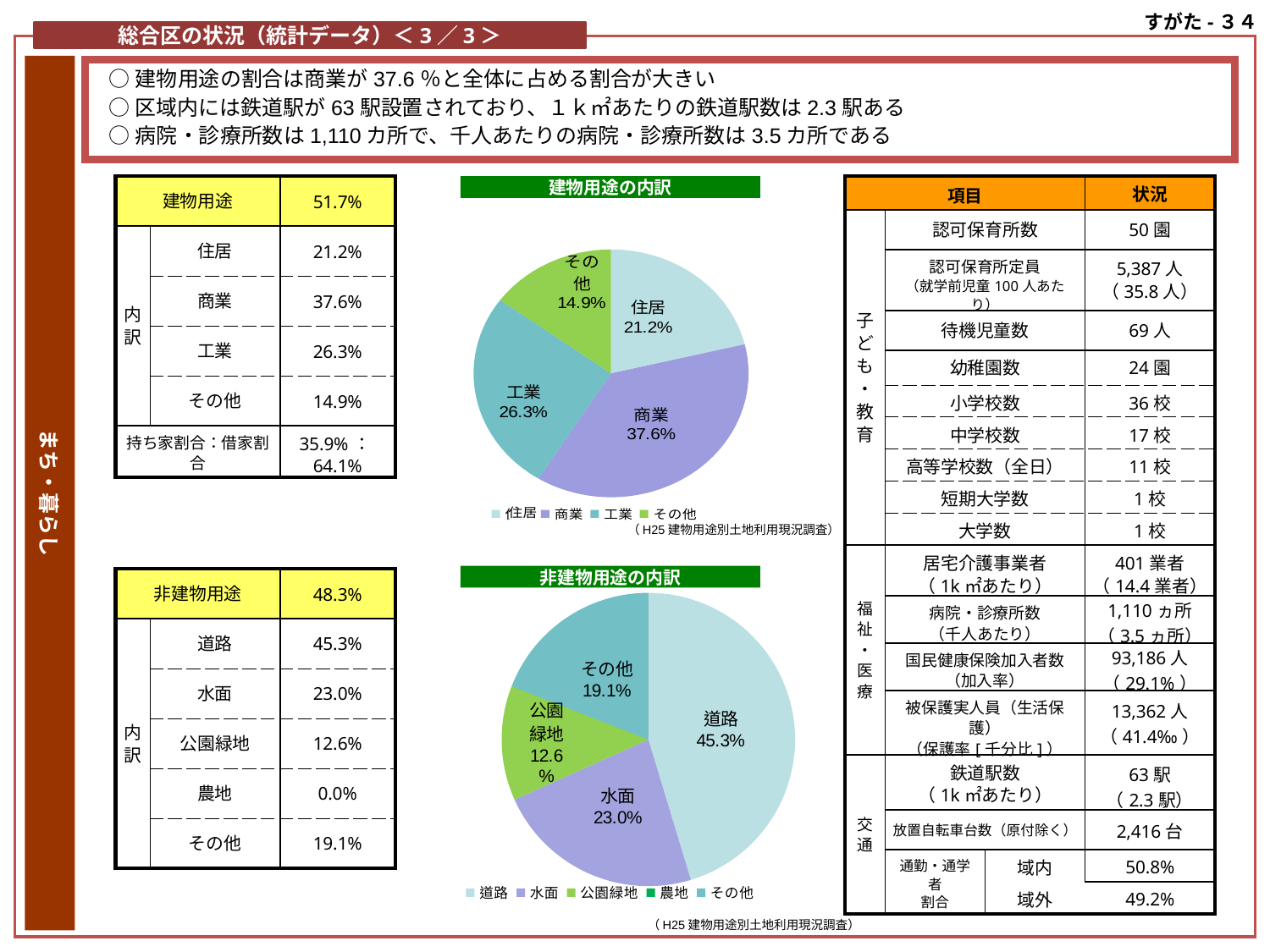
In the 非建物用途の内訳 pie chart, what is the difference between the shares of 道路 and 水面? 22.3% In the 建物用途の内訳 pie chart, what share does 商業 have? 37.6% In the 非建物用途の内訳 pie chart, which is larger, その他 or 公園緑地? その他 In the 建物用途の内訳 pie chart, which category has the largest share? 商業 In the 建物用途の内訳 pie chart, which category has the smallest share? その他 In the 非建物用途の内訳 pie chart, how many categories does the legend list? 5 In the 非建物用途の内訳 pie chart, what is the share of 公園緑地? 12.6% What type of chart is 建物用途の内訳? Pie chart In the 非建物用途の内訳 pie chart, what share does 水面 have? 23.0% In the 建物用途の内訳 pie chart, how many categories does the legend list? 4 In the 非建物用途の内訳 pie chart, which category has the largest share? 道路 In the 建物用途の内訳 pie chart, what is the difference between the shares of 商業 and 住居? 16.4%